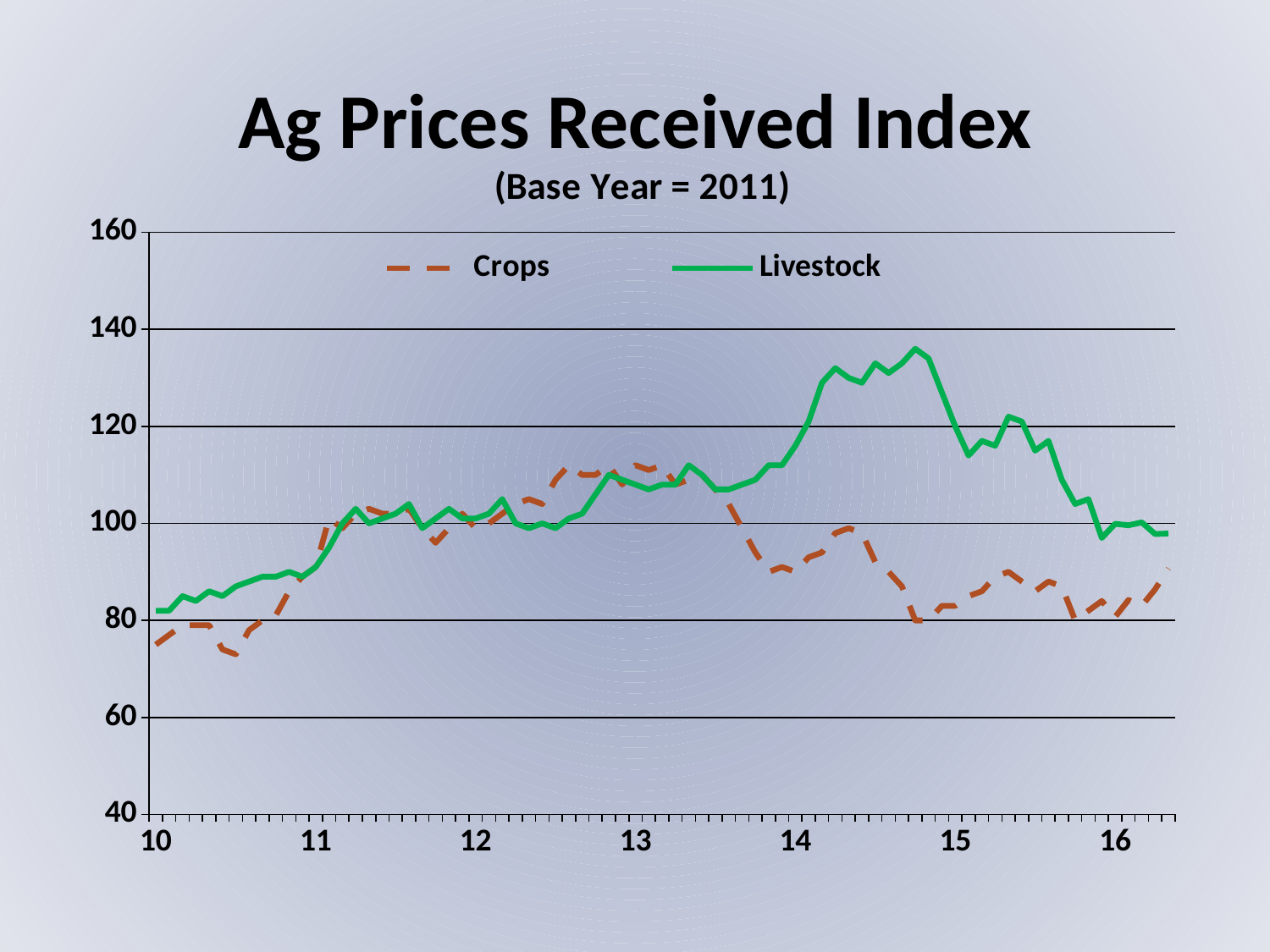
Is the Livestock value at the start of 2016 greater or less than 120? less How many series does the legend list? 2 What is the title of the chart? Ag Prices Received Index Which series is drawn with a dashed line? Crops Is the Crops value at the start of 2015 greater or less than 100? less At the start of 2015, which series has the higher value, Crops or Livestock? Livestock Does the Crops line rise or fall between 2013 and 2015? fall Is the highest value reached by the Livestock line greater or less than 120? greater What kind of chart is shown on the slide? line chart Which series reaches the higher peak over the whole period? Livestock Does the Livestock line rise or fall between the start of 2013 and the end of 2014? rise